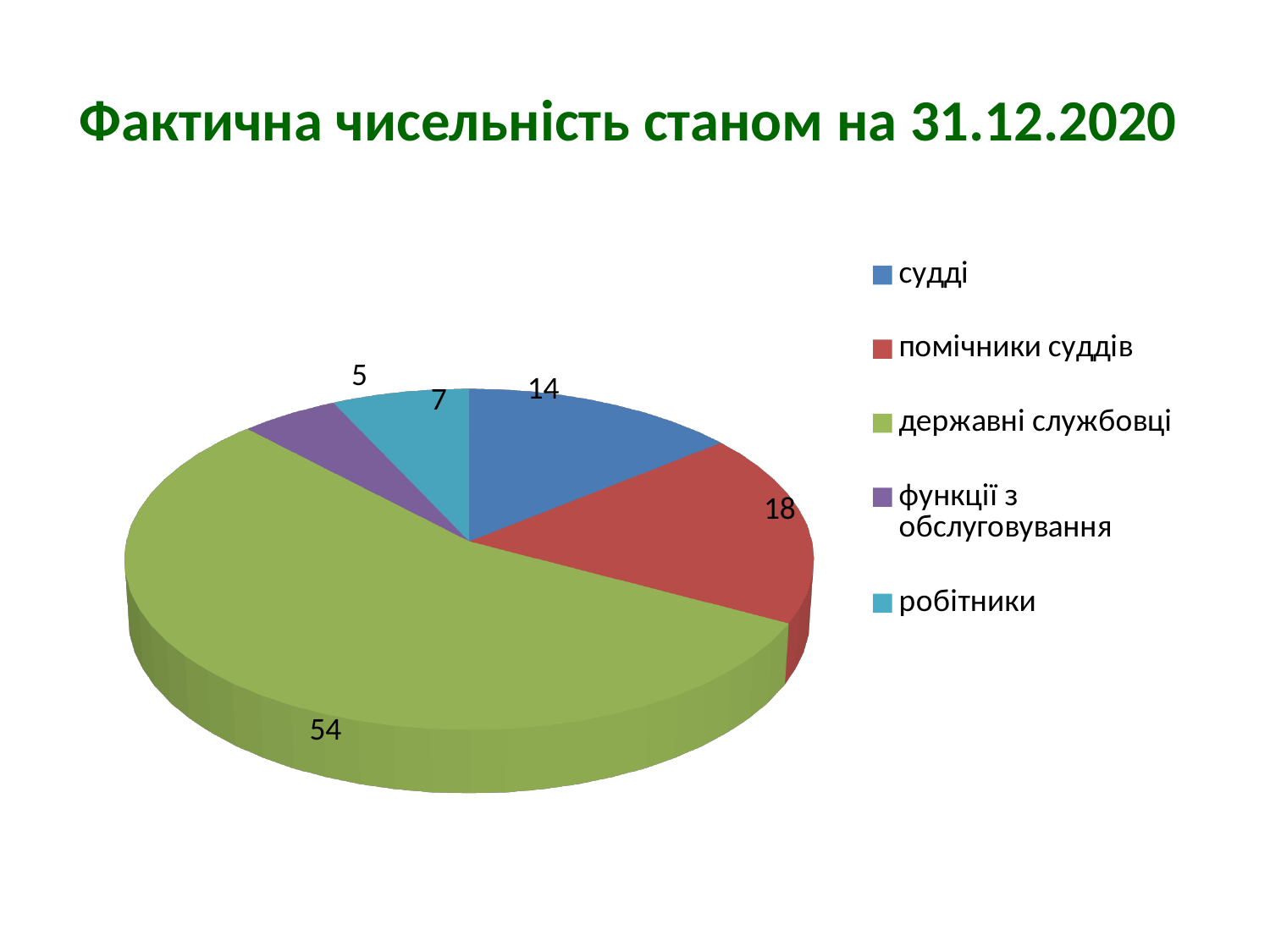
How many categories does the legend list? 5 What is the value for судді? 14 Which category has the smallest slice? функції з обслуговування What is the value for робітники? 7 What is the value for державні службовці? 54 Which is larger, the value for судді or the value for помічники суддів? помічники суддів What is the title of the chart? Фактична чисельність станом на 31.12.2020 What type of chart is shown on the slide? pie chart What is the difference between the values for державні службовці and помічники суддів? 36 What is the value for функції з обслуговування? 5 What is the value for помічники суддів? 18 Which category has the largest slice? державні службовці